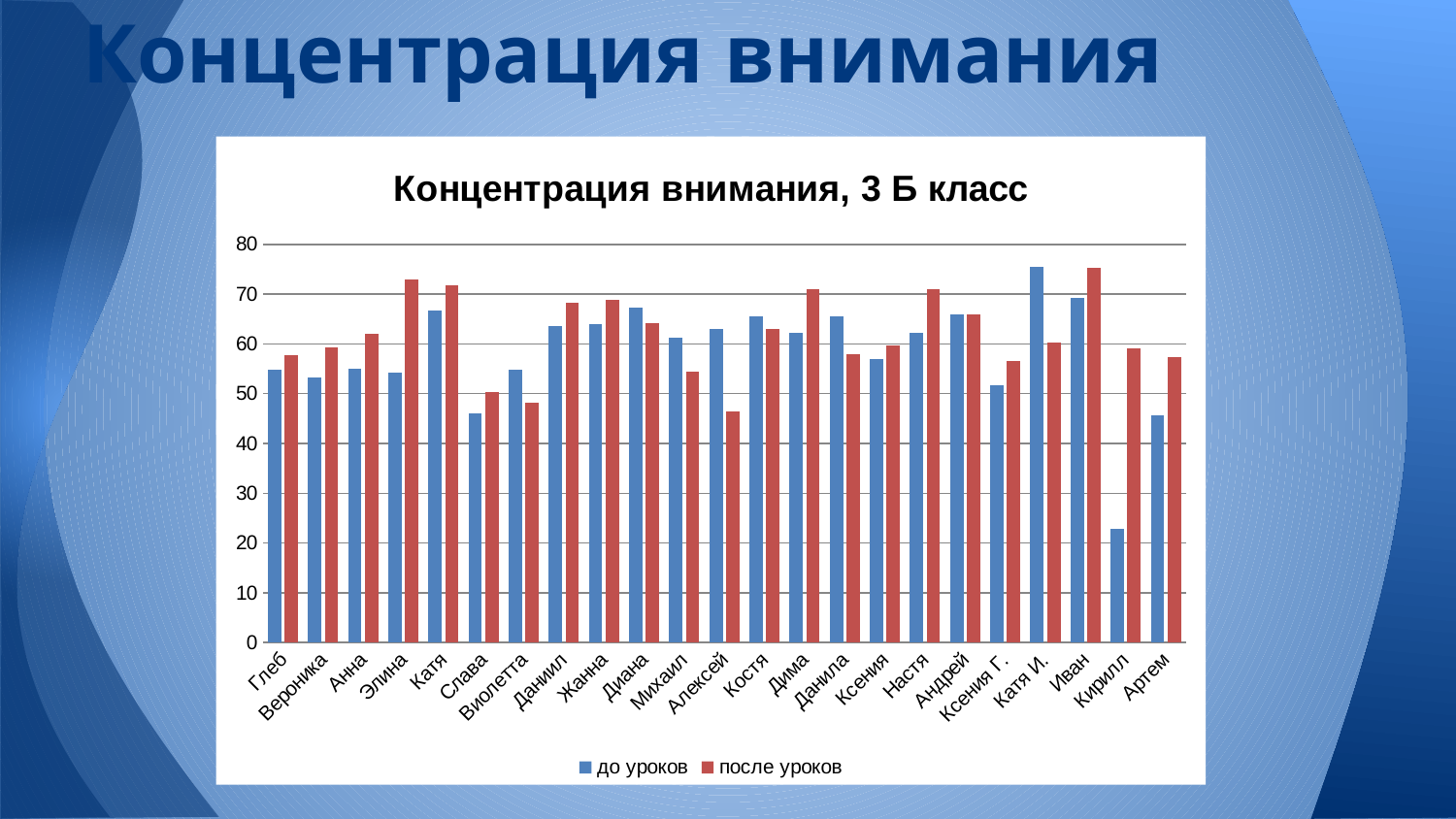
How many students (categories) are shown on the x axis? 23 For Алексей, which is larger: 'до уроков' or 'после уроков'? до уроков Is the 'до уроков' value for Катя И. greater or less than 70? greater Is the 'после уроков' value for Алексей greater or less than 50? less For Кирилл, which is larger: 'до уроков' or 'после уроков'? после уроков Which student has the lowest value for 'до уроков'? Кирилл What is the title of the chart? Концентрация внимания, 3 Б класс Is the 'до уроков' value for Кирилл greater or less than 30? less Which colour represents the 'после уроков' series? red What kind of chart is shown on the slide? bar chart How many series does the legend list? 2